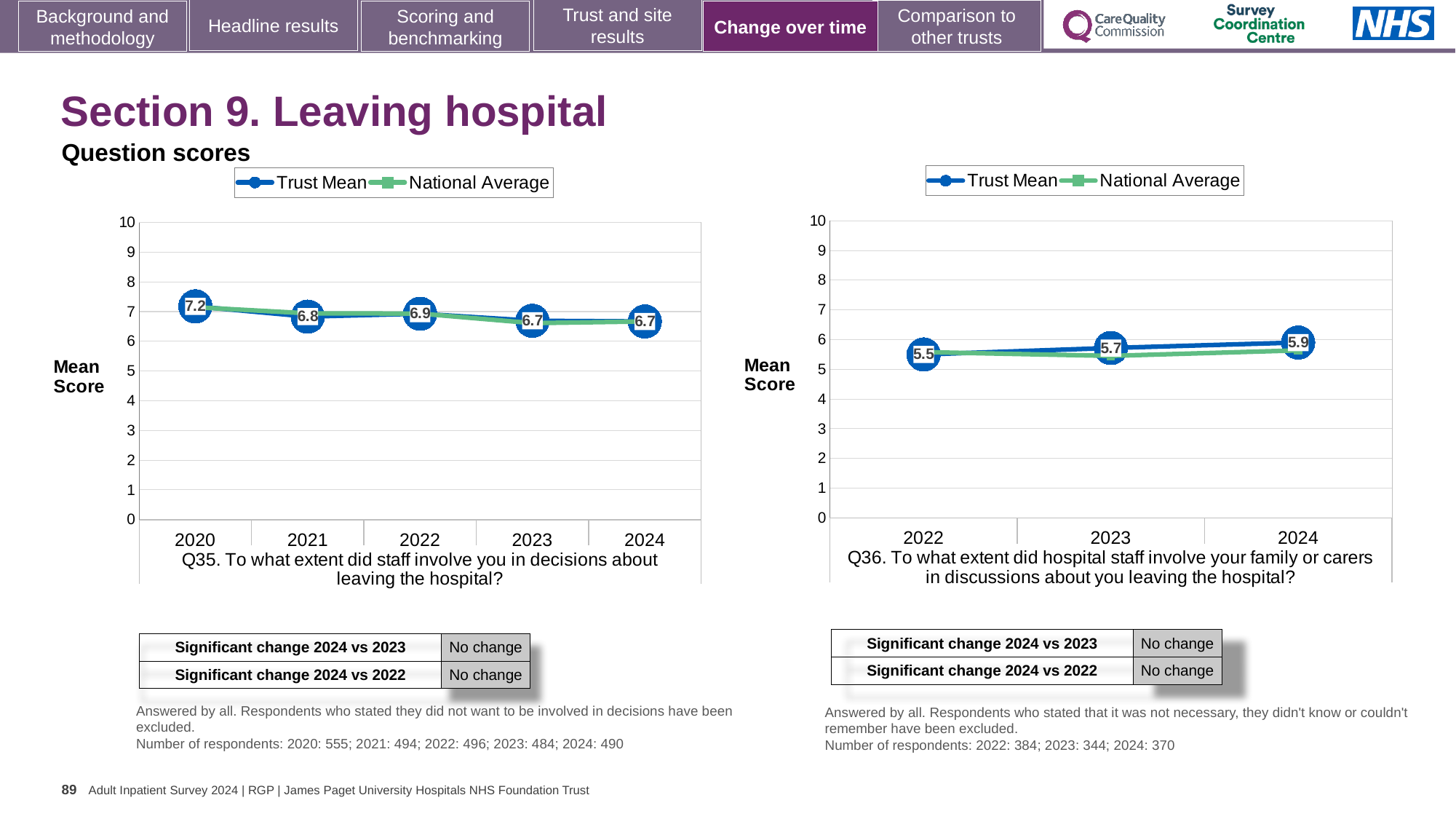
On the Q35 chart (left), what is the Trust Mean score for 2024? 6.7 On the Q35 chart (left), which year has the highest Trust Mean score? 2020 On the Q35 chart (left), what is the difference between the Trust Mean scores for 2020 and 2024? 0.5 On the Q36 chart (right), what is the difference between the Trust Mean scores for 2024 and 2022? 0.4 On the Q36 chart (right), what is the Trust Mean score for 2023? 5.7 How many years are plotted on the Q36 chart (right)? 3 How many series does the legend of the Q35 chart (left) list? 2 On the Q36 chart (right), which year has the highest Trust Mean score? 2024 On the Q36 chart (right), which year has the lowest Trust Mean score? 2022 What type of chart is used for Q36 (right)? Line chart On the Q35 chart (left), what is the Trust Mean score for 2020? 7.2 On the Q35 chart (left), is the Trust Mean score for 2021 greater or less than 7? less